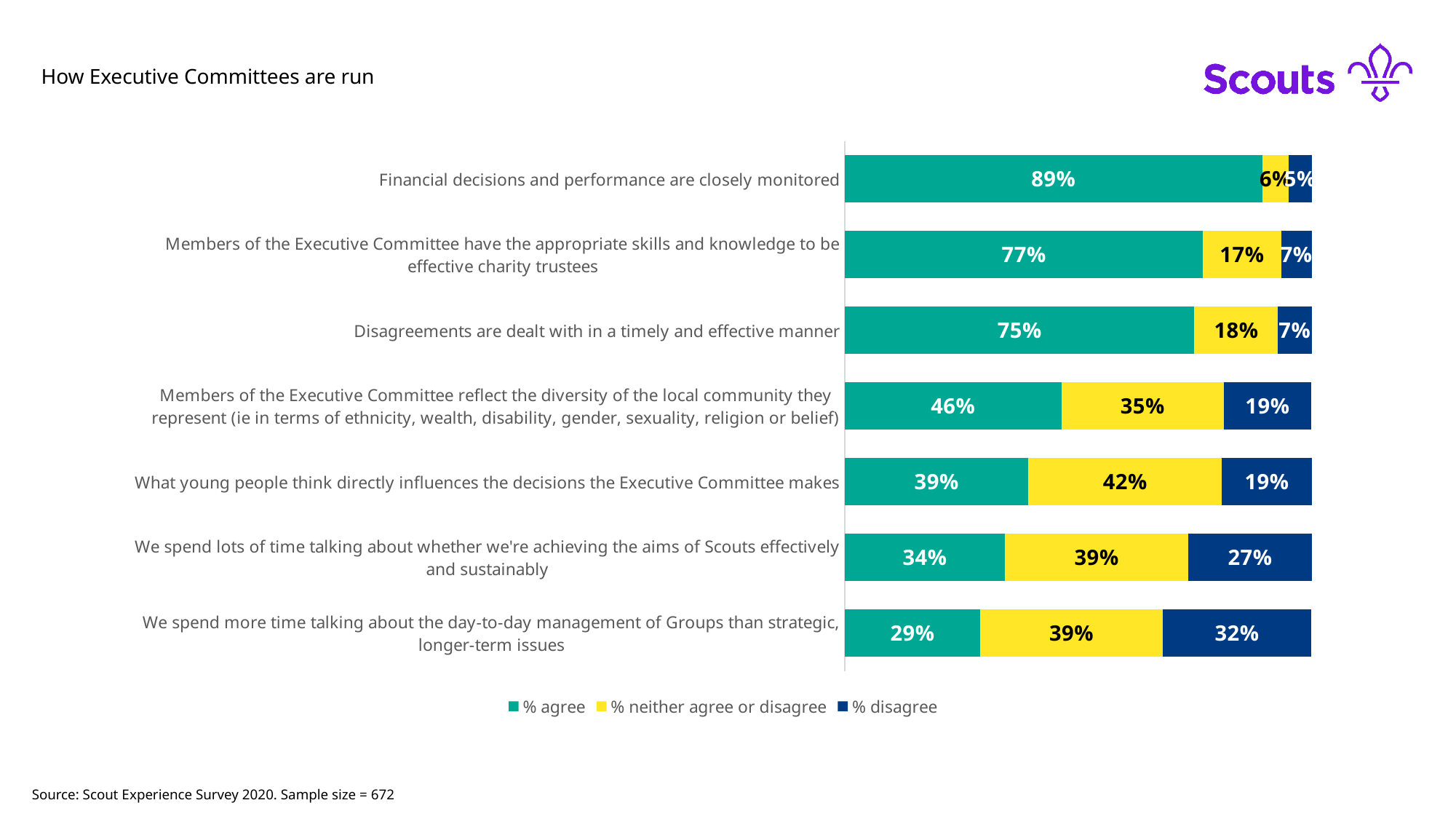
How many series does the legend list? 3 What is the difference in % agree between 'Members of the Executive Committee have the appropriate skills and knowledge to be effective charity trustees' and 'Disagreements are dealt with in a timely and effective manner'? 2% How many statements are shown in the chart? 7 What is the % disagree value for 'We spend more time talking about the day-to-day management of Groups than strategic, longer-term issues'? 32% What kind of chart is shown on the slide? Stacked bar chart What is the title of the slide? How Executive Committees are run Which is larger: the % disagree for 'We spend lots of time talking about whether we're achieving the aims of Scouts effectively and sustainably' or the % disagree for 'Members of the Executive Committee reflect the diversity of the local community they represent'? We spend lots of time talking about whether we're achieving the aims of Scouts effectively and sustainably Which statement has the highest % agree value? Financial decisions and performance are closely monitored Which statement has the lowest % agree value? We spend more time talking about the day-to-day management of Groups than strategic, longer-term issues Which colour represents '% disagree' in the chart? Dark blue What percentage agree that financial decisions and performance are closely monitored? 89% What is the % neither agree or disagree value for 'What young people think directly influences the decisions the Executive Committee makes'? 42%